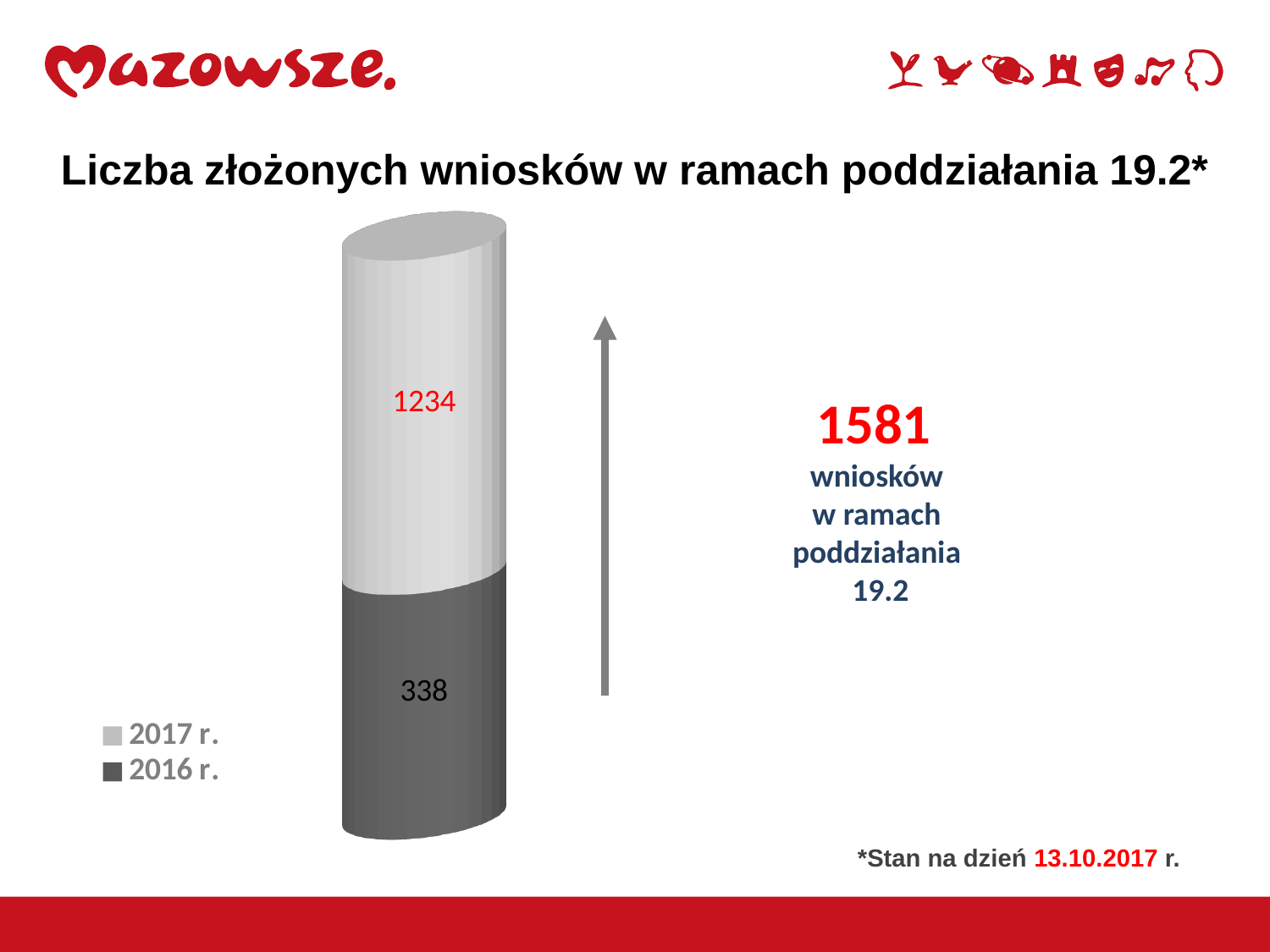
Which legend entry is shown in the lighter grey colour? 2017 r. How many series does the legend list? 2 Which series has the higher value, 2017 r. or 2016 r.? 2017 r. What is the value for 2017 r. in the chart? 1234 How many bars are plotted in the chart? 1 What is the difference between the 2017 r. value and the 2016 r. value? 896 Which series has the lowest value in the chart? 2016 r. What kind of chart is shown on the slide? Stacked bar chart What is the title of the chart on the slide? Liczba złożonych wniosków w ramach poddziałania 19.2* What is the value for 2016 r. in the chart? 338 Which series has the highest value in the chart? 2017 r.